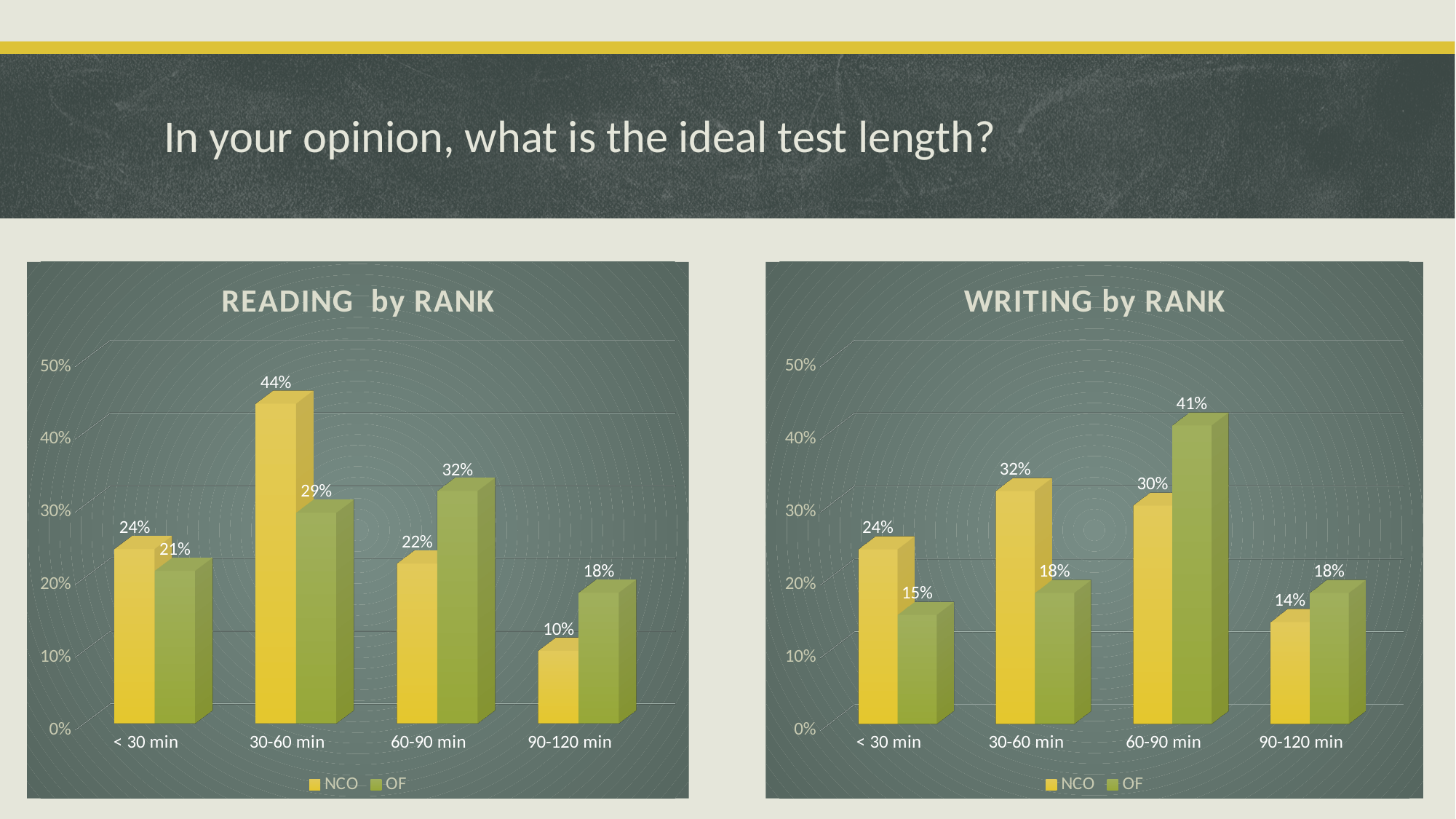
How many series does the legend of the READING by RANK chart list? 2 How many categories are shown on the x axis of the WRITING by RANK chart? 4 In the READING by RANK chart, what is the OF value for 90-120 min? 18% In the WRITING by RANK chart, which category has the lowest OF value? < 30 min What kind of chart is the READING by RANK chart? bar chart In the READING by RANK chart, what is the difference between the NCO and OF values for 30-60 min? 15% In the READING by RANK chart, what is the NCO value for 30-60 min? 44% In the WRITING by RANK chart, what is the difference between the OF values for 60-90 min and 90-120 min? 23% In the WRITING by RANK chart, which is larger for 60-90 min, NCO or OF? OF In the READING by RANK chart, which category has the highest NCO value? 30-60 min In the WRITING by RANK chart, what is the OF value for 60-90 min? 41% In the WRITING by RANK chart, what is the NCO value for < 30 min? 24%